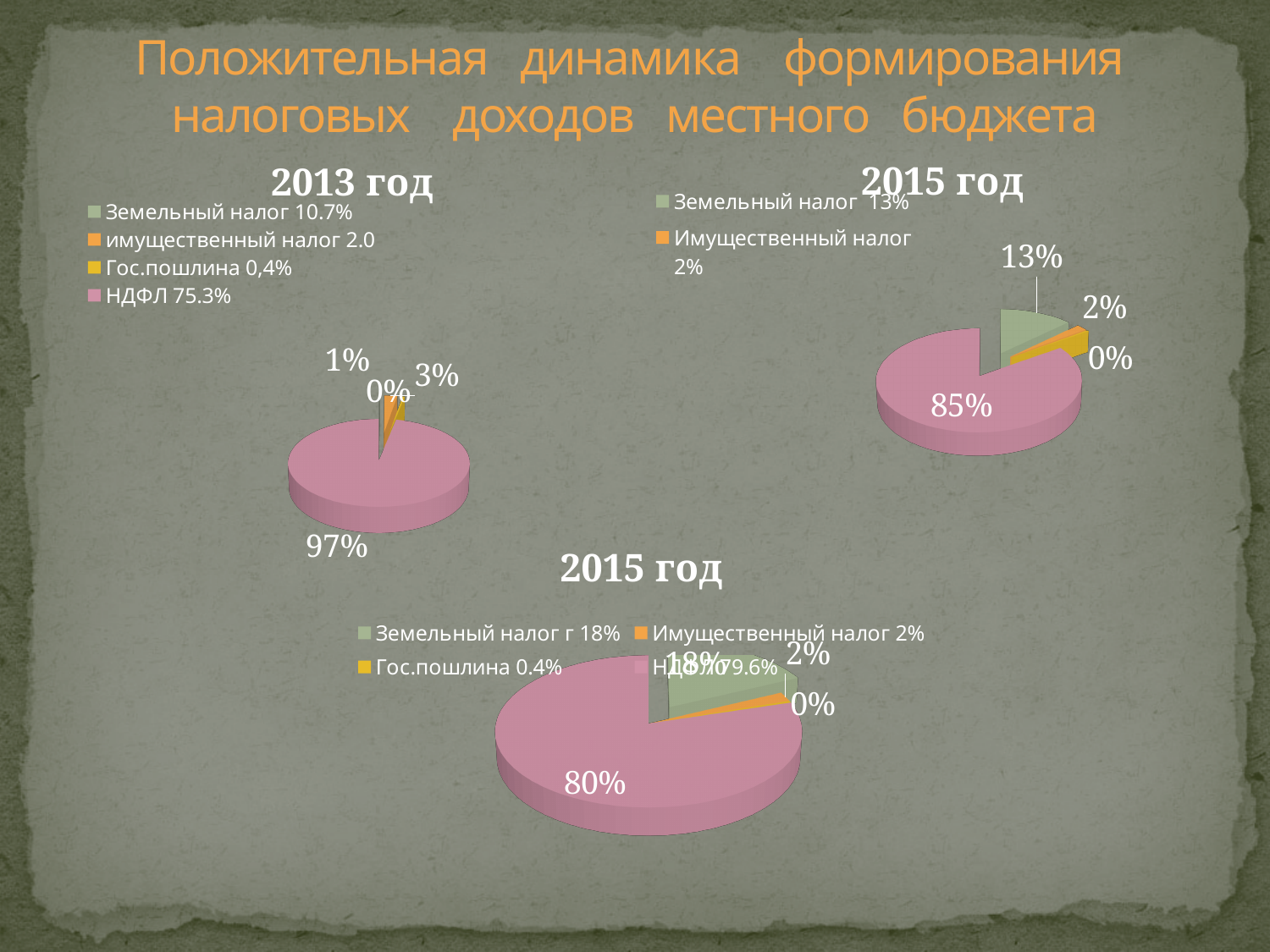
In the top-right chart titled "2015 год", what data label is shown on the largest (pink) slice? 85% In the top-left chart titled "2013 год", what data label is shown on the largest (pink) slice? 97% In the bottom chart titled "2015 год", what data label is shown on the green Земельный налог slice? 18% In the top-left chart titled "2013 год", which category does the legend list with the value 75.3%? НДФЛ In the top-right chart titled "2015 год", what is the difference between the 85% slice and the 13% slice? 72% In the bottom chart titled "2015 год", what data label is shown on the largest (pink) slice? 80% In the top-right chart titled "2015 год", what data label is shown on the green Земельный налог slice? 13% What type of chart is the top-left chart titled "2013 год"? pie chart In the top-left chart titled "2013 год", what data label is shown on the green Земельный налог slice? 0% In the bottom chart titled "2015 год", which slice is larger: Земельный налог or Имущественный налог? Земельный налог In the bottom chart titled "2015 год", what value does the legend give for Гос.пошлина? 0.4% How many entries does the legend of the top-left chart titled "2013 год" list? 4